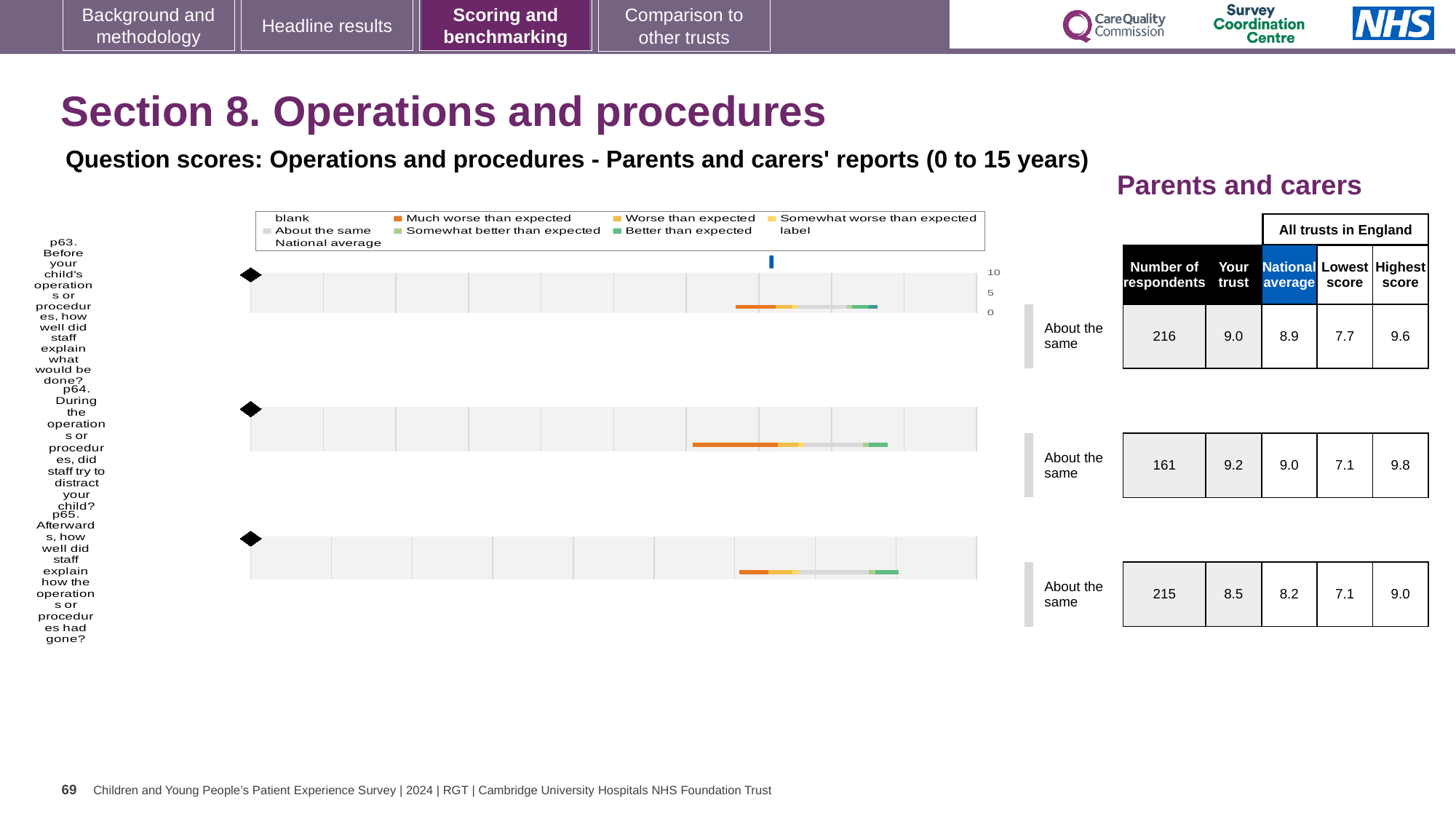
What is the difference between the 'Your trust' score and the national average for p64? 0.2 What is the highest score among all trusts in England for p64? 9.8 What benchmark category label is shown next to the chart for p65? About the same What kind of chart is used to show the question scores? Bar chart How many respondents answered p65 (Afterwards, how well did staff explain how the operations or procedures had gone?)? 215 For p63, which is larger: the 'Your trust' score or the national average? Your trust What is the national average score for p63 (Before your child's operations or procedures, how well did staff explain what would be done?)? 8.9 What is the lowest score among all trusts in England for p63? 7.7 Which question has the lowest 'Your trust' score? p65 Which question has the highest 'Your trust' score? p64 What is the 'Your trust' score for p64 (During the operations or procedures, did staff try to distract your child?)? 9.2 How many survey questions are plotted as rows in the chart? 3